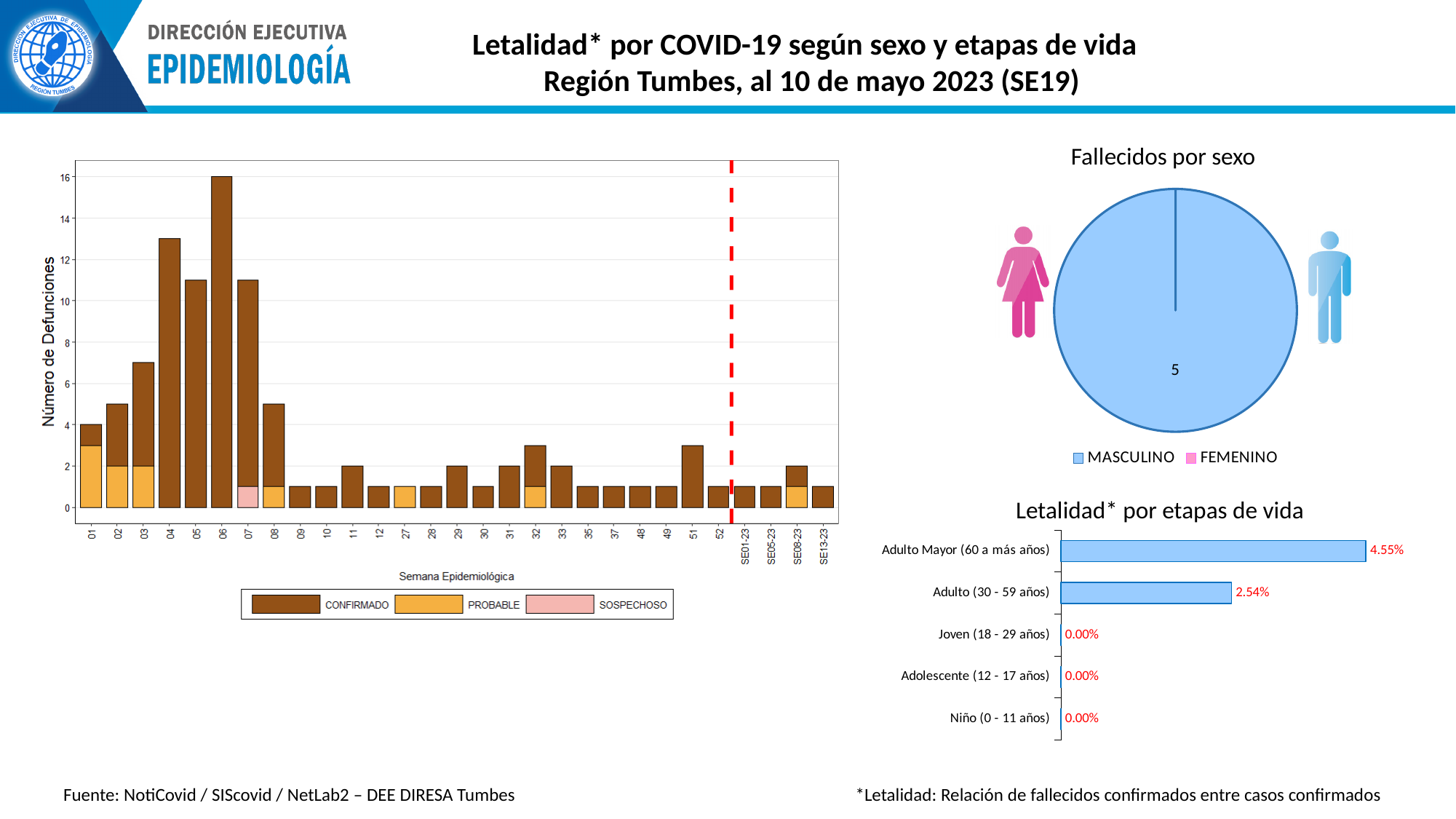
In the 'Letalidad* por etapas de vida' chart, which age group has the highest value? Adulto Mayor (60 a más años) In the left-hand chart of deaths by epidemiological week, which has more deaths, week 04 or week 05? 04 In the 'Letalidad* por etapas de vida' chart, what is the value for Adulto (30 - 59 años)? 2.54% How many age groups are shown in the 'Letalidad* por etapas de vida' chart? 5 In the 'Letalidad* por etapas de vida' chart, what is the difference between the values for Adulto Mayor (60 a más años) and Adulto (30 - 59 años)? 2.01% In the left-hand chart of deaths by epidemiological week, how many deaths are shown for week 06? 16 How many entries does the legend of the 'Fallecidos por sexo' pie chart list? 2 In the 'Letalidad* por etapas de vida' chart, what is the value for Adulto Mayor (60 a más años)? 4.55% How many series does the legend of the left-hand chart (Número de Defunciones by Semana Epidemiológica) list? 3 What kind of chart is 'Letalidad* por etapas de vida'? bar chart In the 'Fallecidos por sexo' pie chart, what value is shown for MASCULINO? 5 In the left-hand chart of deaths by epidemiological week, which week has the highest number of deaths? 06